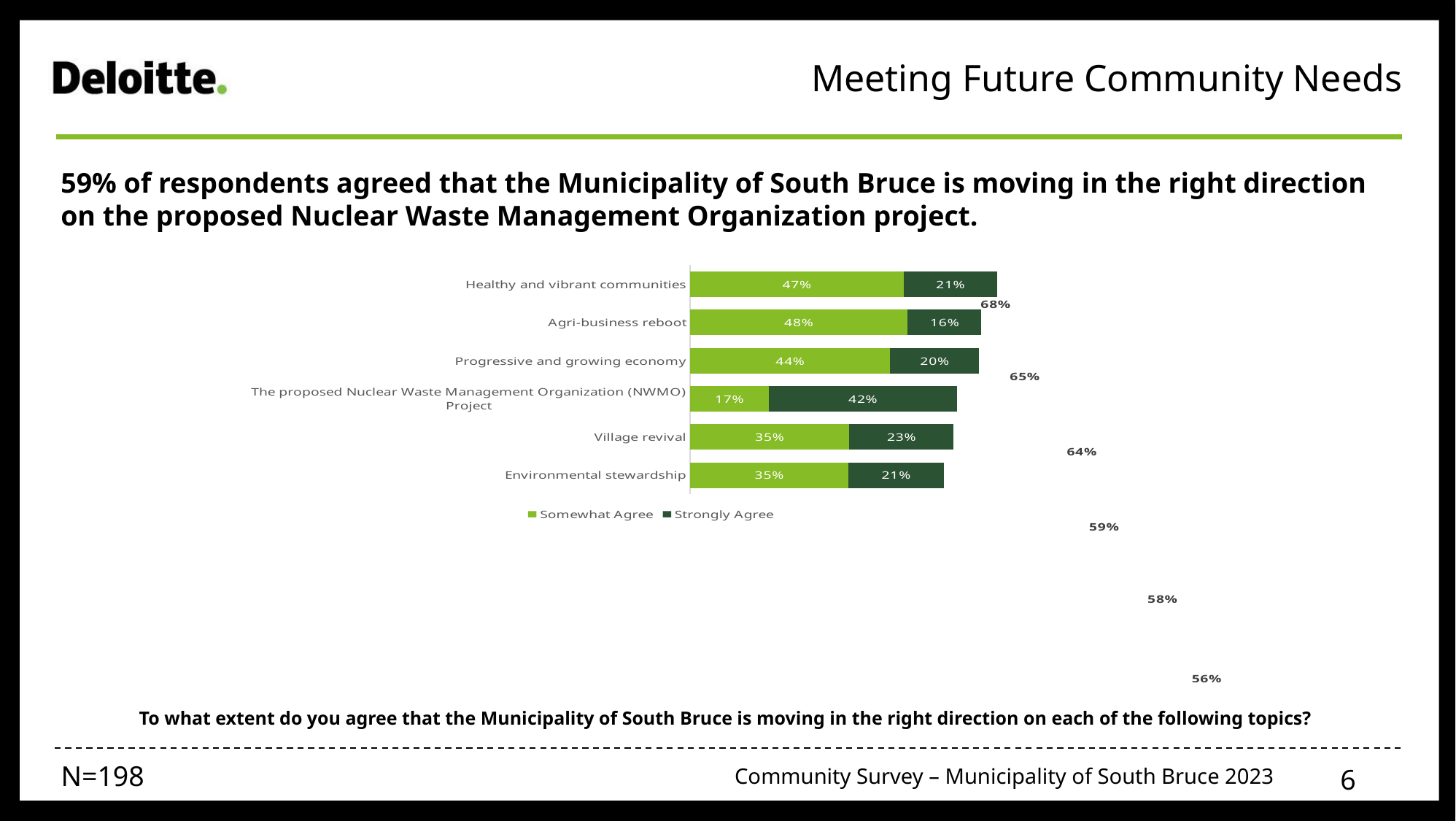
Which is larger: the Strongly Agree value for Village revival or for Environmental stewardship? Village revival Which category has the lowest Somewhat Agree value? The proposed Nuclear Waste Management Organization (NWMO) Project What is the Strongly Agree value for The proposed Nuclear Waste Management Organization (NWMO) Project? 42% What are the two legend entries in the chart? Somewhat Agree and Strongly Agree What kind of chart is shown on the slide? Stacked bar chart How many topics (categories) are plotted in the chart? 6 What is the Somewhat Agree value for Healthy and vibrant communities? 47% What is the difference between the Somewhat Agree values for Agri-business reboot and Village revival? 13% What is the Strongly Agree value for Agri-business reboot? 16% How many series does the legend list? 2 What is the combined Somewhat Agree and Strongly Agree total for Healthy and vibrant communities? 68% Which category has the highest Strongly Agree value? The proposed Nuclear Waste Management Organization (NWMO) Project